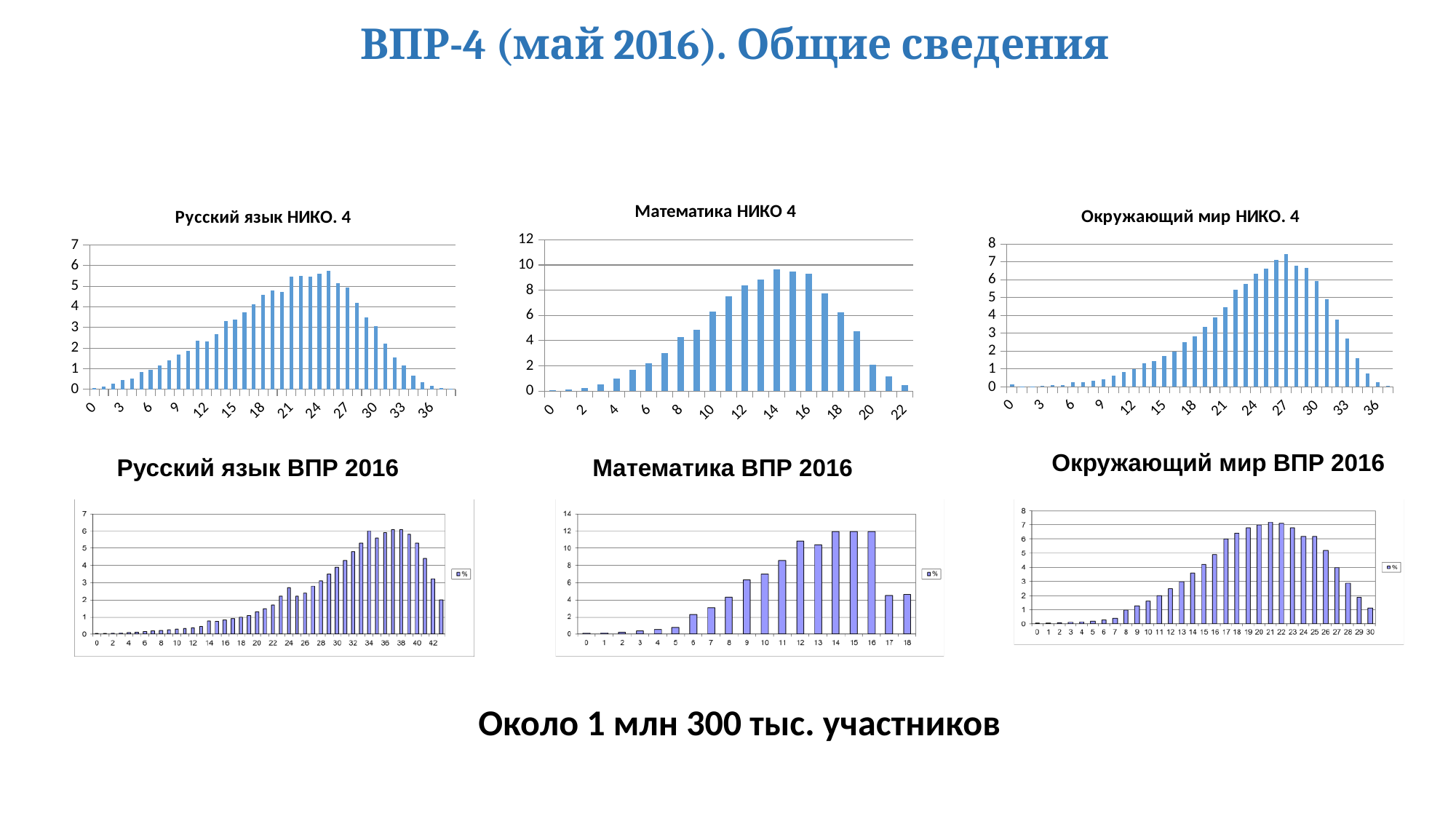
In the "Математика ВПР 2016" chart, is the value for 17 greater or less than 6? less In the "Математика НИКО 4" chart, is the value for 22 greater or less than 2? less How many bars are plotted in the "Математика ВПР 2016" chart? 19 In the "Окружающий мир ВПР 2016" chart, is the value for 30 greater or less than 2? less In the "Математика НИКО 4" chart, do the values rise or fall along the x axis from 0 to 14? rise What kind of chart is "Математика НИКО 4"? bar chart How many series does the legend of the "Математика ВПР 2016" chart list? 1 In the "Математика НИКО 4" chart, which is larger, the value for 8 or the value for 20? 8